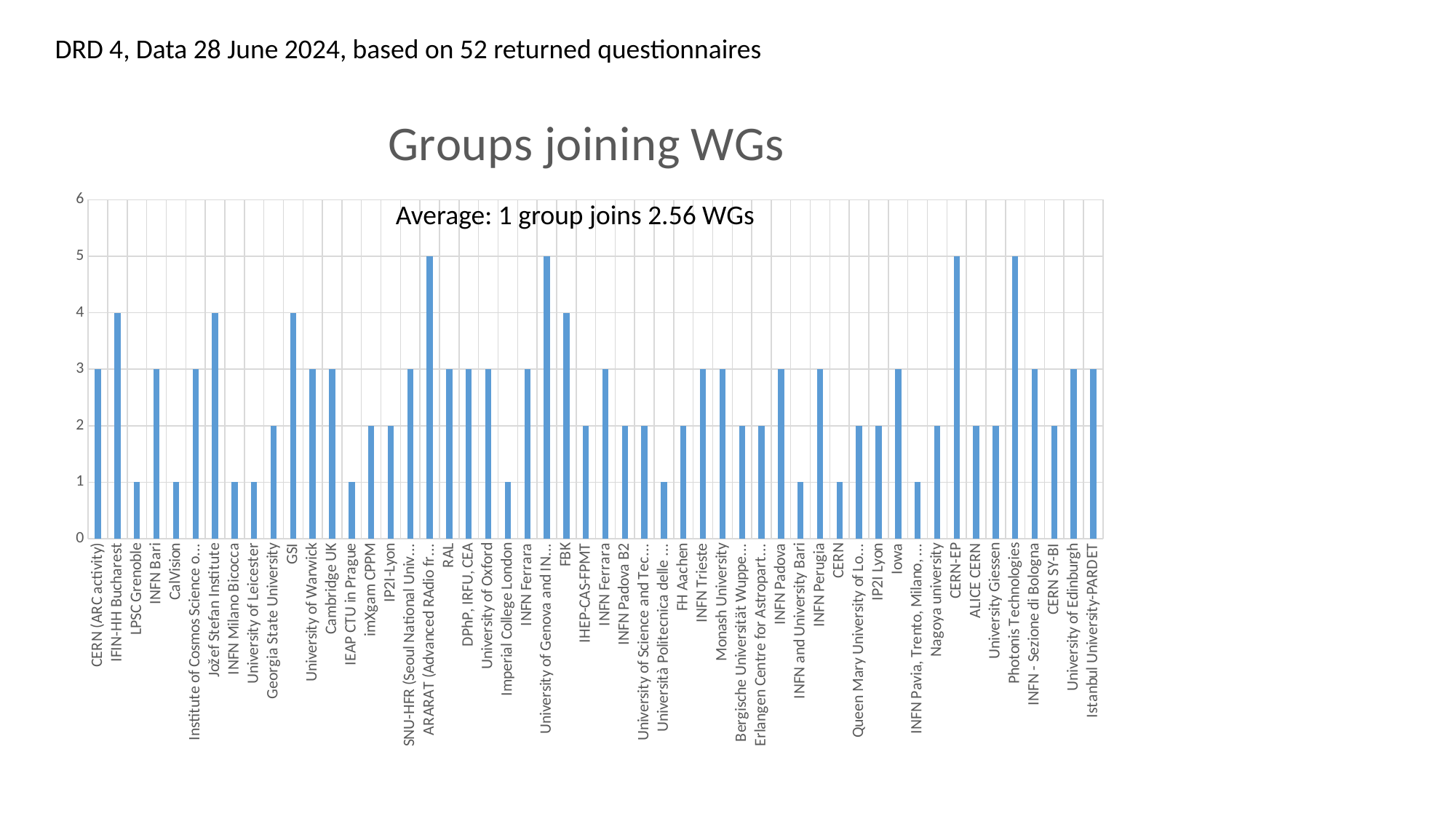
What is the difference between the value for CERN-EP and the value for CERN? 4 What is the value for University of Oxford? 3 What kind of chart is shown on the slide? bar chart Is the value for FBK greater or less than 3? greater Which is larger, the value for IFIN-HH Bucharest or the value for CalVision? IFIN-HH Bucharest What is the value for Nagoya university? 2 What is the value for Photonis Technologies? 5 What is the title of the chart? Groups joining WGs What is the highest value reached by any bar in the chart? 5 What average is stated in the text inside the chart? 1 group joins 2.56 WGs How many WGs does GSI join according to the chart? 4 What is the value for LPSC Grenoble? 1